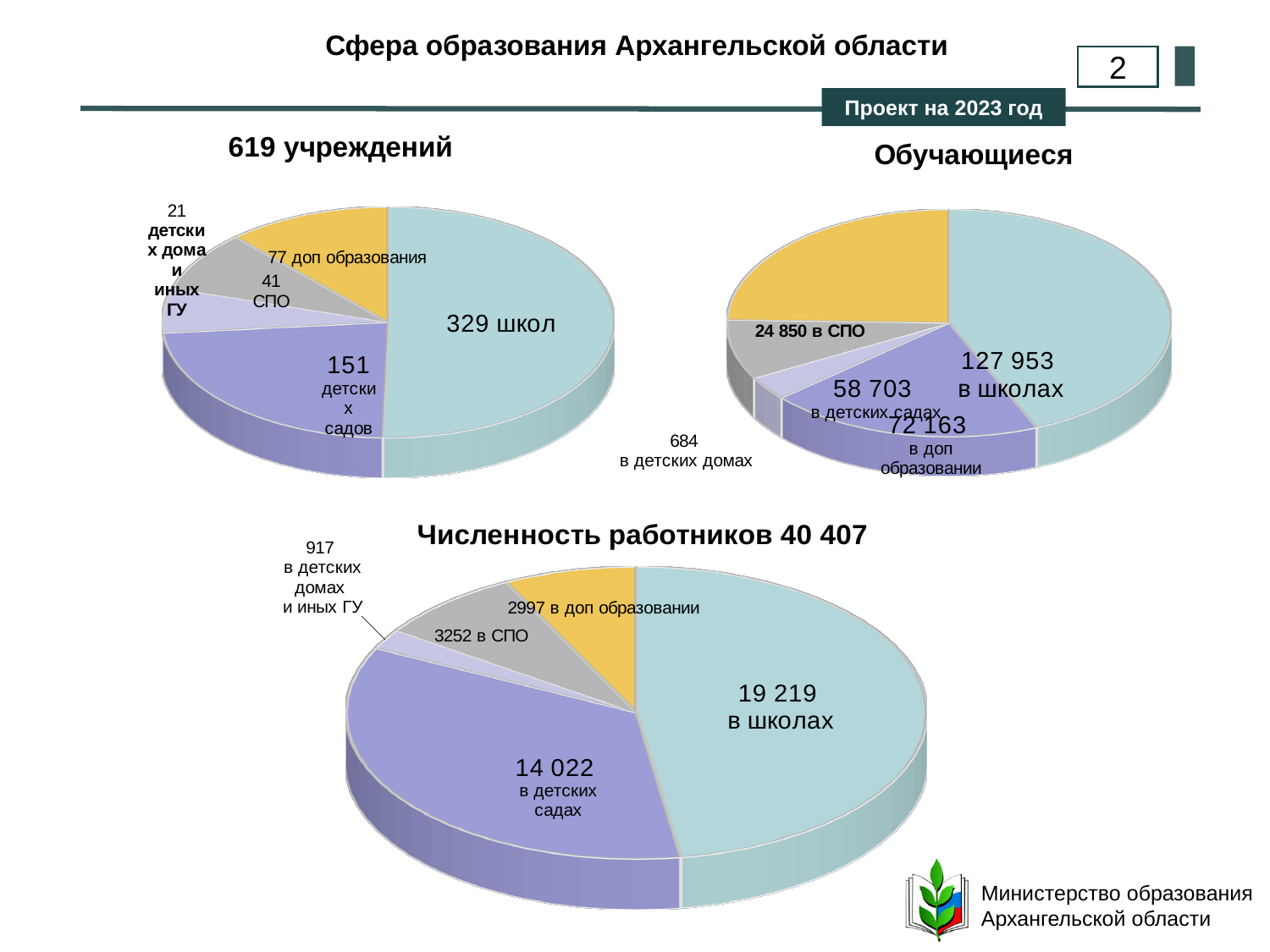
In the 'Обучающиеся' chart, how many students are in schools (в школах)? 127 953 In the '619 учреждений' chart, how many kindergartens (детских садов) are shown? 151 In the '619 учреждений' chart, what is the difference between the number of schools and the number of kindergartens? 178 In the 'Обучающиеся' chart, how many students are in СПО? 24 850 In the 'Обучающиеся' chart, which is larger: the value for kindergartens (в детских садах) or for supplementary education (в доп образовании)? в доп образовании (72 163) In the 'Численность работников 40 407' chart, how many employees work in kindergartens (в детских садах)? 14 022 What type of chart is used for 'Обучающиеся'? Pie chart In the 'Обучающиеся' chart, which category has the largest value? в школах In the '619 учреждений' chart, which category has the smallest value? детских домов и иных ГУ (21) How many slices does the 'Численность работников 40 407' chart have? 5 In the '619 учреждений' chart, how many schools (школ) are shown? 329 In the 'Численность работников 40 407' chart, what is the difference between employees in schools and employees in kindergartens? 5 197